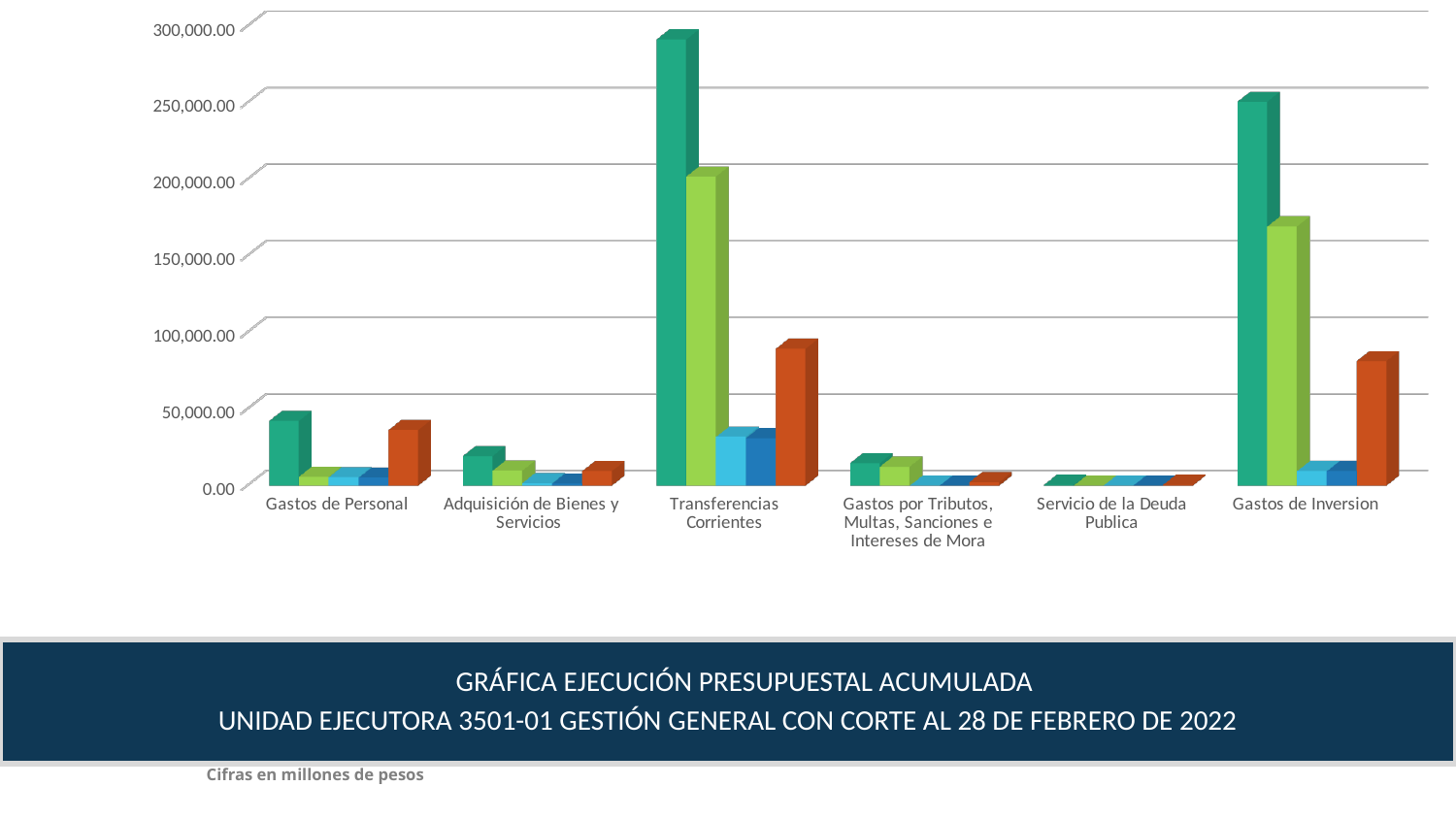
How many categories are shown on the x axis of the chart? 6 Is the value of the second (light green) bar for Gastos de Inversion greater or less than 150,000.00? greater What kind of chart is shown on the slide? bar chart Which category has the smallest bars overall in the chart? Servicio de la Deuda Publica According to the note below the chart, in what units are the figures expressed? millones de pesos Is the value of the first (teal) bar for Transferencias Corrientes greater or less than 250,000.00? greater Which category has the tallest bar in the chart? Transferencias Corrientes Which has the larger first (teal) bar: Transferencias Corrientes or Gastos de Inversion? Transferencias Corrientes Is the value of the second (light green) bar for Transferencias Corrientes greater or less than 150,000.00? greater Which has the larger last (orange) bar: Gastos de Personal or Adquisición de Bienes y Servicios? Gastos de Personal